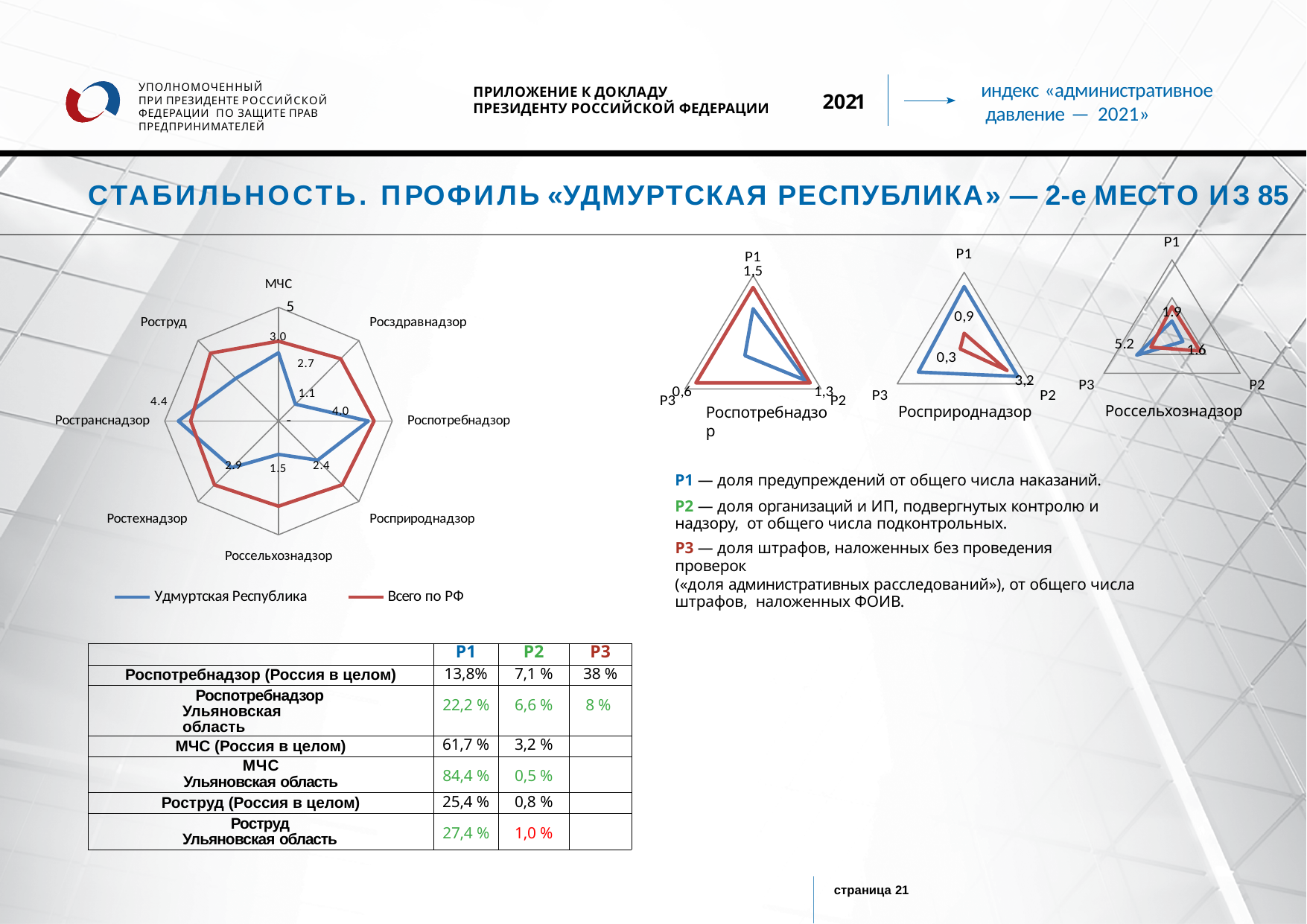
On the large radar chart on the left, what is the value for Удмуртская Республика for Ространснадзор? 4.4 On the large radar chart on the left, what is the value for Удмуртская Республика for Россельхознадзор? 1.5 On the large radar chart on the left, which is larger for Удмуртская Республика: Роспотребнадзор or Россельхознадзор? Роспотребнадзор On the large radar chart on the left, is the value for Всего по РФ for МЧС greater or less than 3? greater On the large radar chart on the left, what is the value for Удмуртская Республика for Роспотребнадзор? 4.0 What kind of chart is the large chart on the left of the slide? Radar chart How many categories (axes) does the large radar chart on the left have? 8 On the large radar chart on the left, what is the difference between the Удмуртская Республика values for Ространснадзор and Роструд? 1.7 How many series does the legend of the large radar chart on the left list? 2 What are the two legend entries of the large radar chart on the left? Удмуртская Республика and Всего по РФ On the large radar chart on the left, which category has the highest value for Удмуртская Республика? Ространснадзор On the large radar chart on the left, which category has the lowest value for Удмуртская Республика? Росздравнадзор